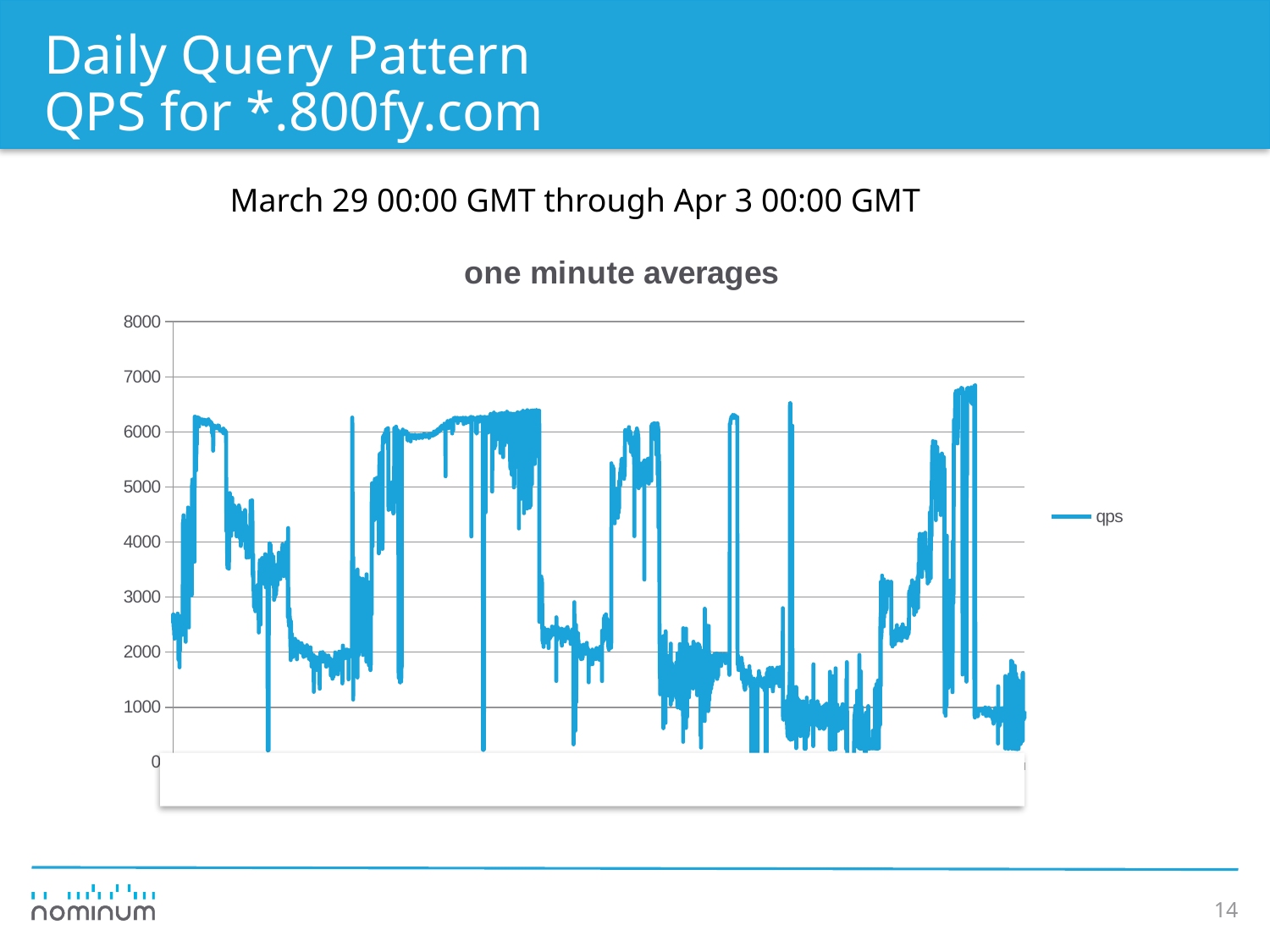
Is the lowest value reached by the qps line greater or less than 1000? less What is the title of the chart? one minute averages What is the name of the series shown in the chart's legend? qps Is the highest value reached by the qps line greater or less than 6000? greater Is the value of the qps line at the very start of the chart greater or less than 4000? less What kind of chart is shown on the slide? line chart How many series does the chart's legend list? 1